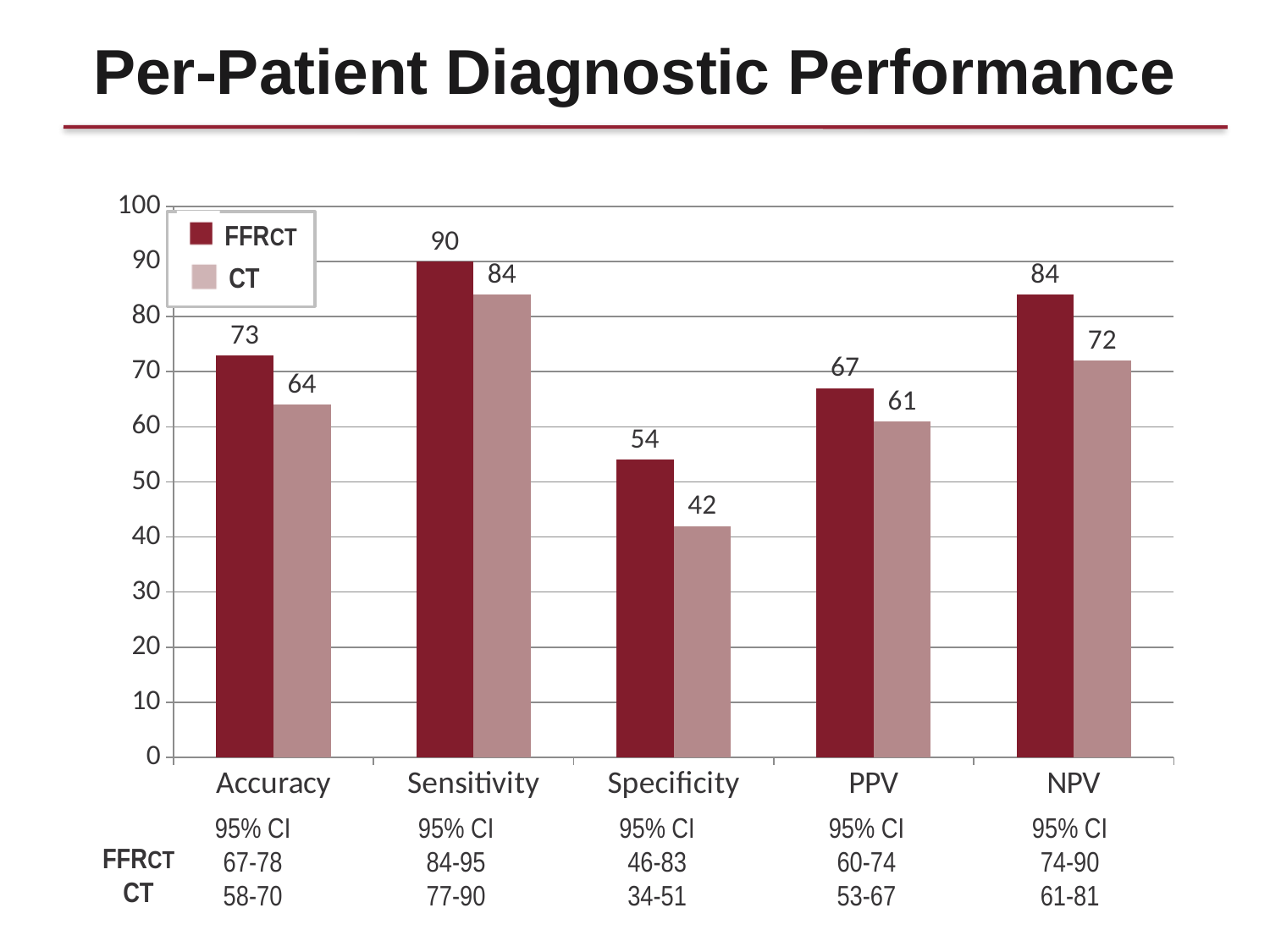
What is the CT value for NPV? 72 What is the FFRCT value for Sensitivity? 90 What kind of chart is shown on the slide? Bar chart Which category has the highest FFRCT value? Sensitivity What is the CT value for Specificity? 42 Which is larger, the FFRCT value for PPV or the CT value for PPV? FFRCT What is the difference between the FFRCT and CT values for Accuracy? 9 Which category has the lowest CT value? Specificity How many categories are shown on the x axis? 5 What is the title of the slide? Per-Patient Diagnostic Performance What is the difference between the FFRCT and CT values for Specificity? 12 How many series does the legend list? 2